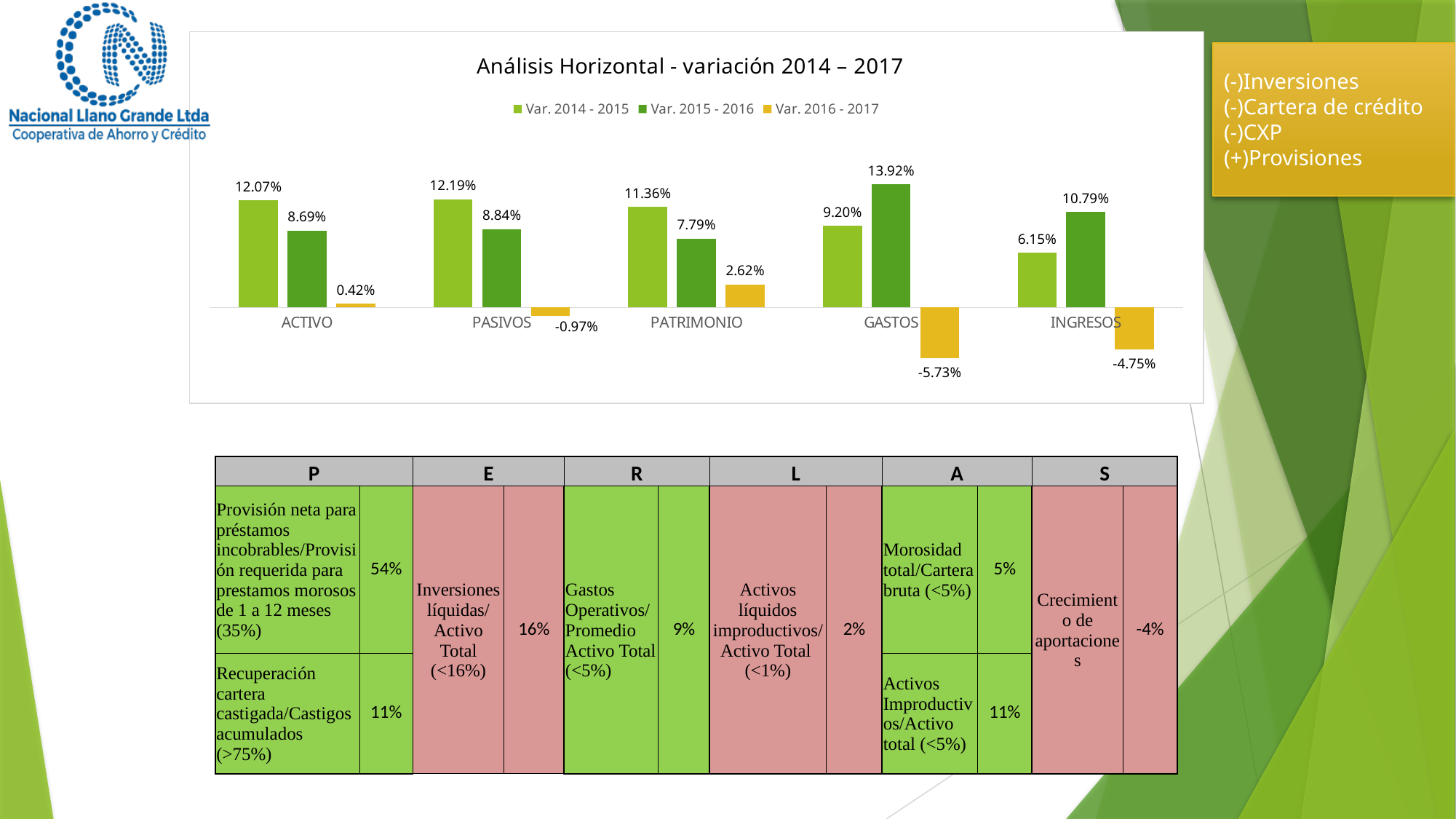
What is the value of Var. 2016 - 2017 for GASTOS? -5.73% How many categories are shown on the x axis of the chart? 5 What is the value of Var. 2016 - 2017 for PASIVOS? -0.97% Which category has the highest value for Var. 2015 - 2016? GASTOS What is the value of Var. 2015 - 2016 for INGRESOS? 10.79% What is the value of Var. 2014 - 2015 for ACTIVO? 12.07% What is the difference between Var. 2014 - 2015 and Var. 2015 - 2016 for PATRIMONIO? 3.57% Which category has the lowest value for Var. 2014 - 2015? INGRESOS How many series does the chart legend list? 3 Which is larger for PASIVOS: Var. 2014 - 2015 or Var. 2015 - 2016? Var. 2014 - 2015 What kind of chart is shown on the slide? Bar chart What is the title of the chart? Análisis Horizontal - variación 2014 – 2017